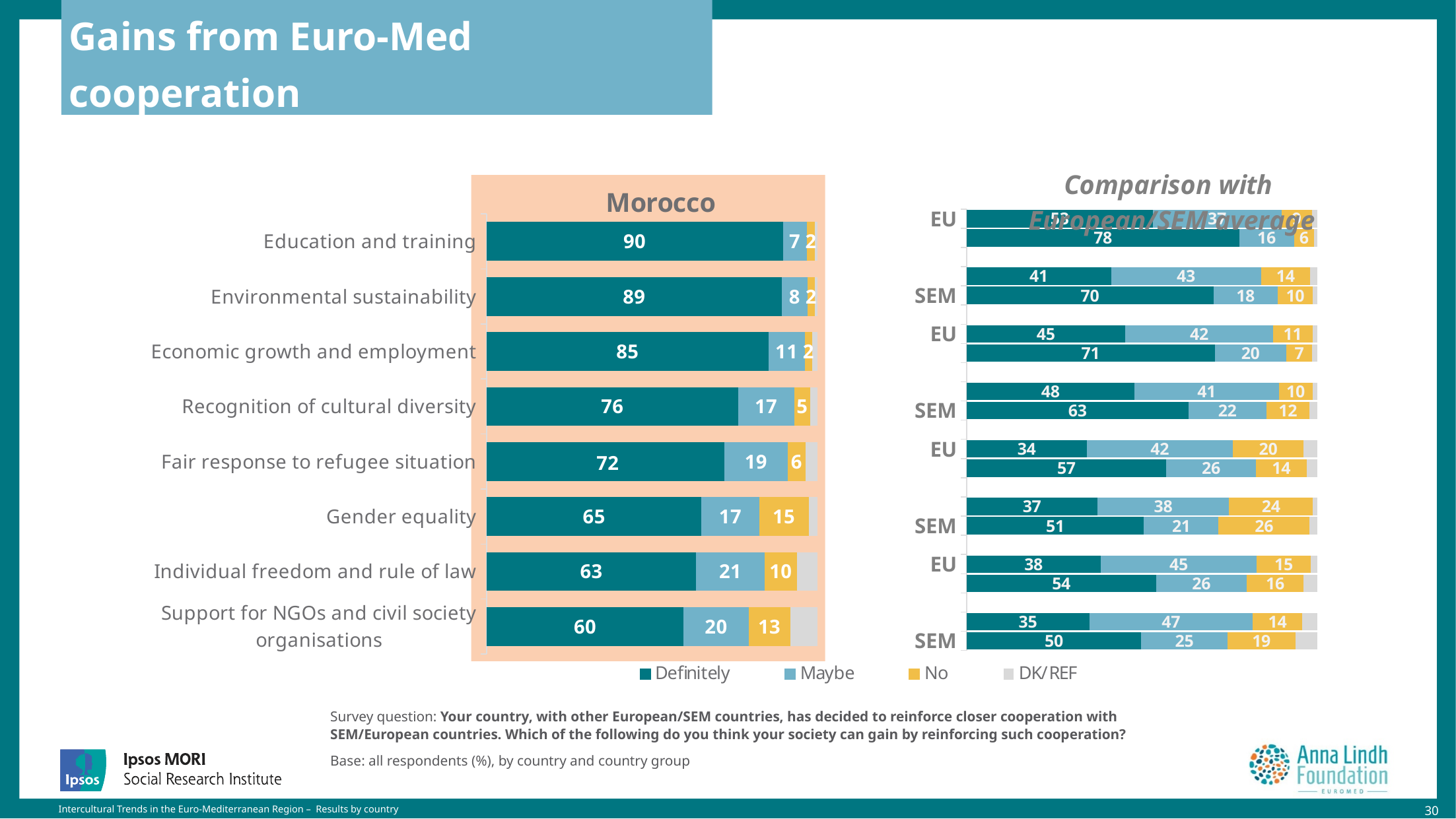
In the Comparison with European/SEM average chart, what is the 'Definitely' value on the bottom SEM bar? 50 How many categories are shown in the Morocco chart? 8 How many series does the legend list? 4 In the Morocco chart, what is the difference between the 'Definitely' values for Education and training and Support for NGOs and civil society organisations? 30 What type of chart is the Morocco chart? Stacked bar chart In the Morocco chart, do the 'Definitely' values rise or fall going from the top category to the bottom category? Fall In the Morocco chart, what is the 'No' value for Gender equality? 15 In the Morocco chart, which category has the lowest 'Definitely' value? Support for NGOs and civil society organisations In the Morocco chart, what is the 'Maybe' value for Individual freedom and rule of law? 21 In the Morocco chart, which category has the highest 'Definitely' value? Education and training In the Morocco chart, which has a larger 'Definitely' value: Recognition of cultural diversity or Fair response to refugee situation? Recognition of cultural diversity In the Morocco chart, what percentage said 'Definitely' for Education and training? 90